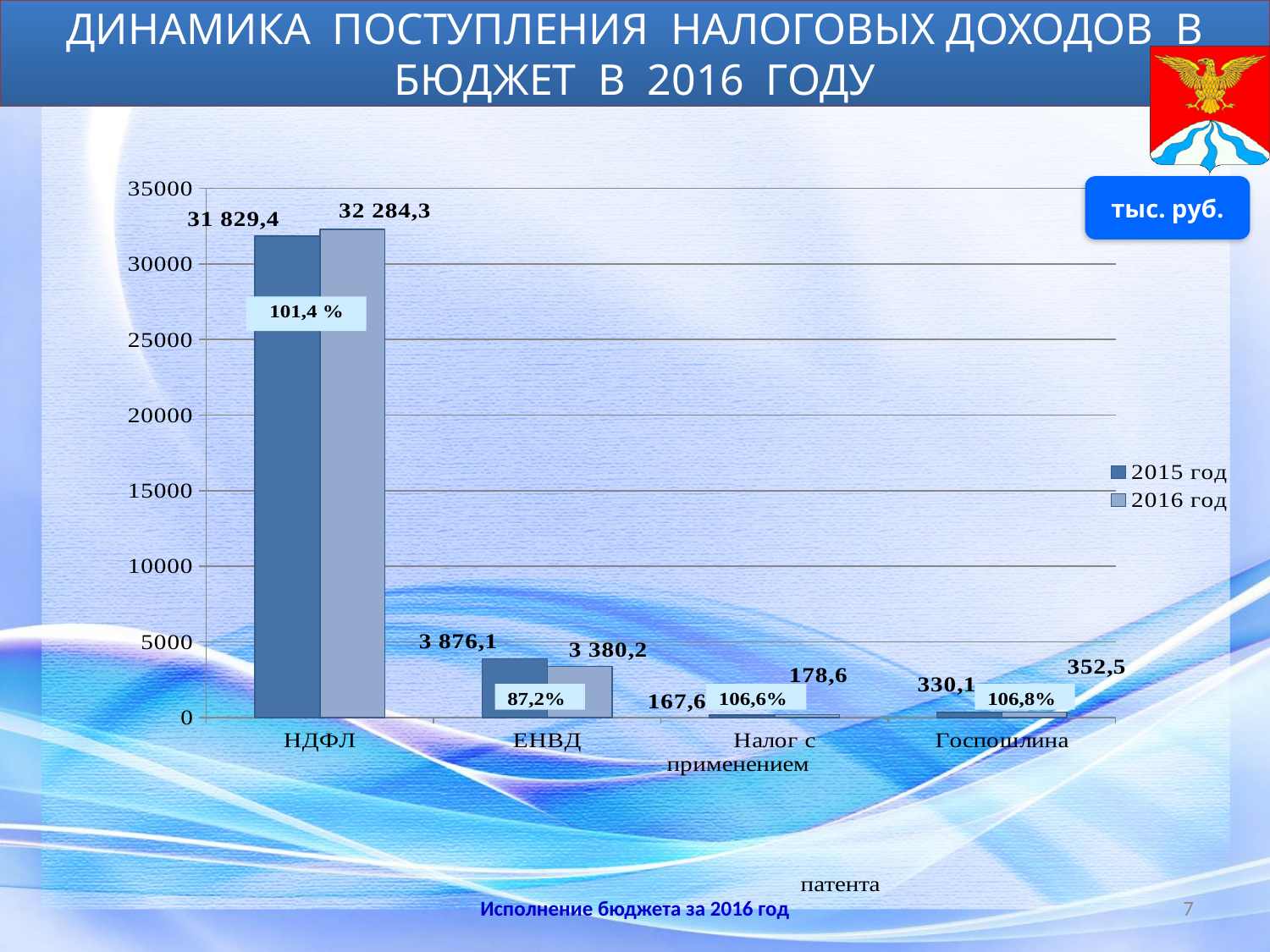
Which category has the highest value in the 2016 год series? НДФЛ How many categories are shown on the x axis? 4 Which category has the lowest value in the 2015 год series? Налог с применением патента What kind of chart is shown on the slide? Bar chart What is the value for НДФЛ in the 2016 год series? 32 284,3 What is the value for ЕНВД in the 2016 год series? 3 380,2 What is the difference between the 2016 год and 2015 год values for НДФЛ? 454,9 What is the value for Госпошлина in the 2015 год series? 330,1 What is the value for НДФЛ in the 2015 год series? 31 829,4 How many series does the legend list? 2 Which is larger for ЕНВД: the 2015 год value or the 2016 год value? 2015 год What is the difference between the 2015 год and 2016 год values for ЕНВД? 495,9